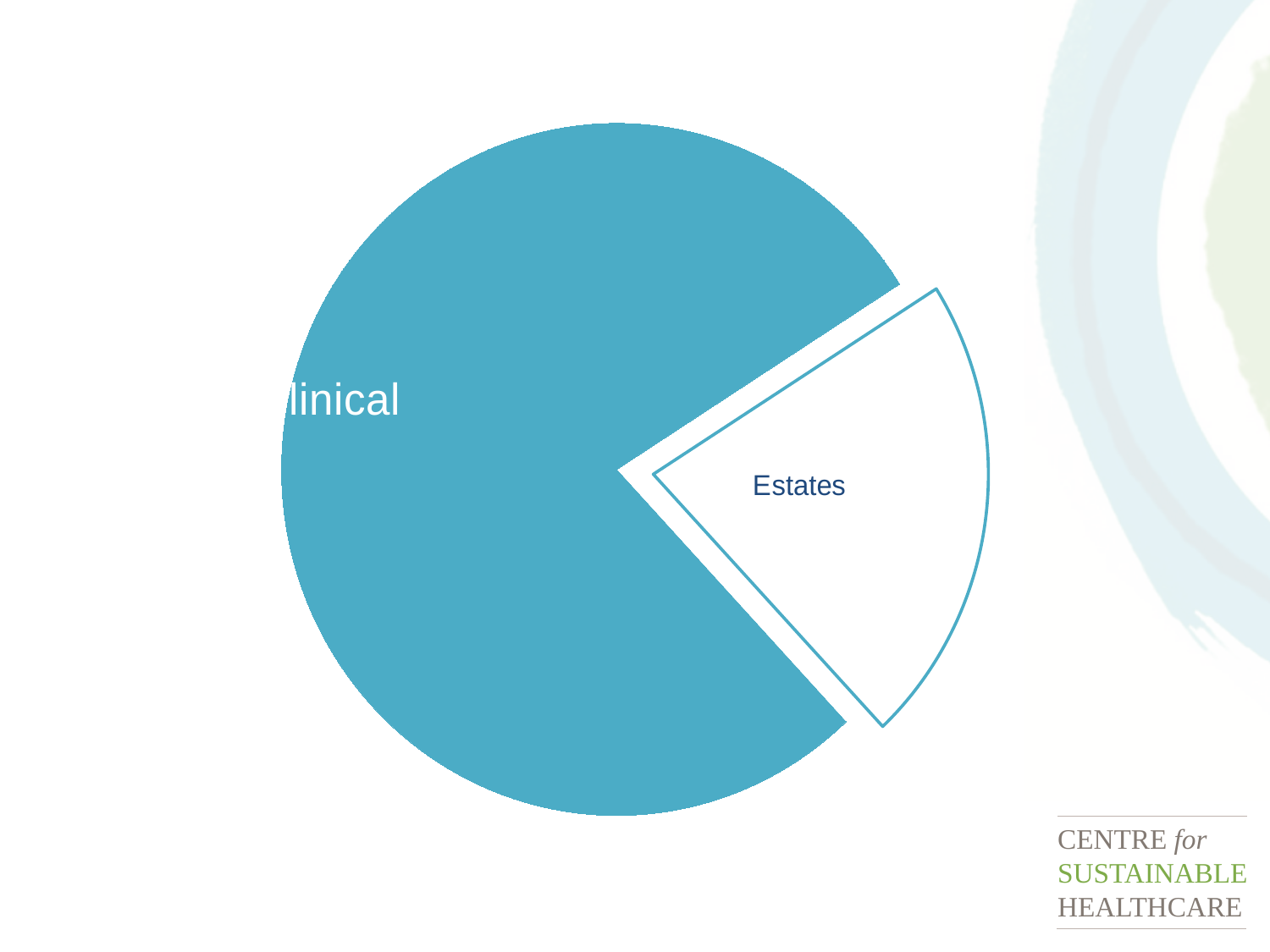
Which slice is larger, Clinical or Estates? Clinical Which slice of the pie chart is pulled out (exploded) from the rest of the pie? Estates What kind of chart is shown on the slide? pie chart What colour is the Clinical slice of the pie chart? teal blue Which slice of the pie chart is the largest? Clinical